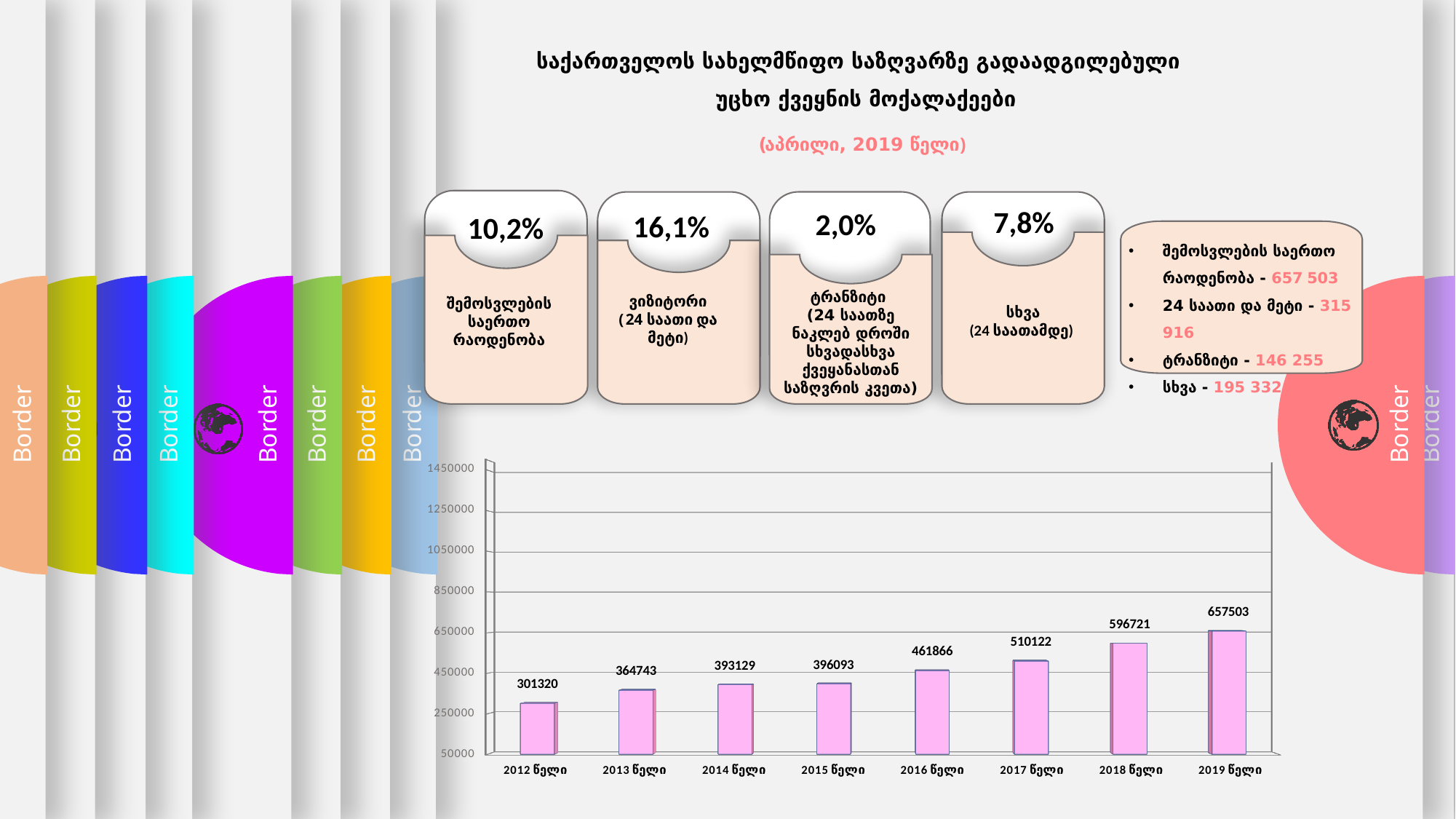
What is the value for 2012 წელი? 301320 Do the values rise or fall from 2012 წელი to 2019 წელი? rise What is the value for 2016 წელი? 461866 Which year has the highest value? 2019 წელი How many years are shown on the x axis? 8 Which year has the lowest value? 2012 წელი Is the value for 2018 წელი greater or less than 650000? less What kind of chart is shown on the slide? bar chart What is the difference between the values for 2019 წელი and 2018 წელი? 60782 What is the value for 2019 წელი? 657503 Which is larger, the value for 2017 წელი or the value for 2015 წელი? 2017 წელი What is the difference between the values for 2013 წელი and 2012 წელი? 63423